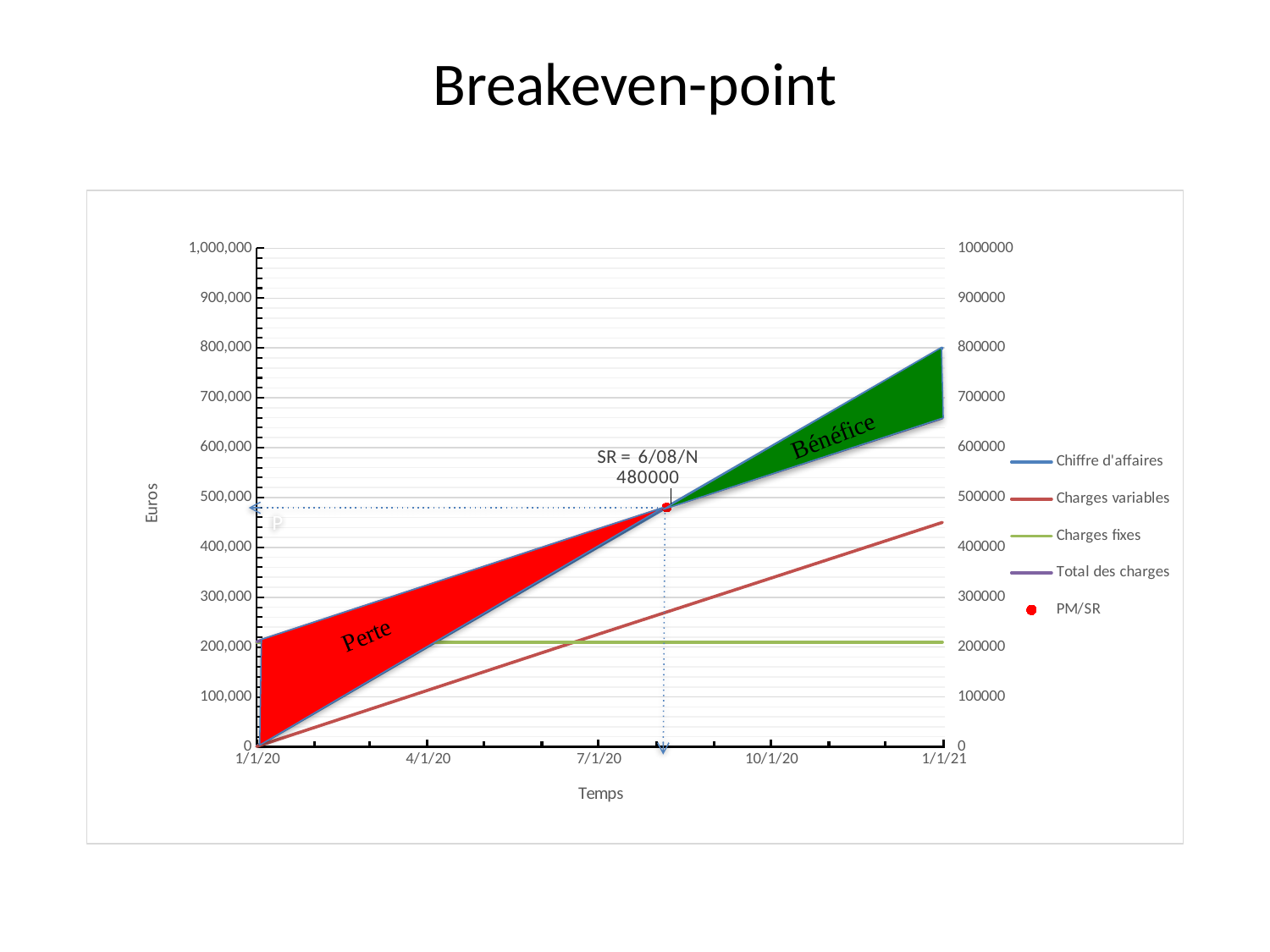
Does Chiffre d'affaires rise or fall from 1/1/20 to 1/1/21? rise What kind of chart is shown on the slide? line chart What date is printed for the breakeven point SR? 6/08/N At 1/1/21, which is larger: Chiffre d'affaires or Charges variables? Chiffre d'affaires Is the value of Charges fixes greater or less than 300,000? less Does the Charges fixes line rise, fall or stay flat along the x axis? stay flat What value is printed at the breakeven point (PM/SR)? 480000 What is the title of the x axis? Temps How many series does the legend list? 5 Is the value of Charges variables at 1/1/21 greater or less than 500,000? less What is the title of the y axis? Euros Is the value of Chiffre d'affaires at 1/1/21 greater or less than 700,000? greater